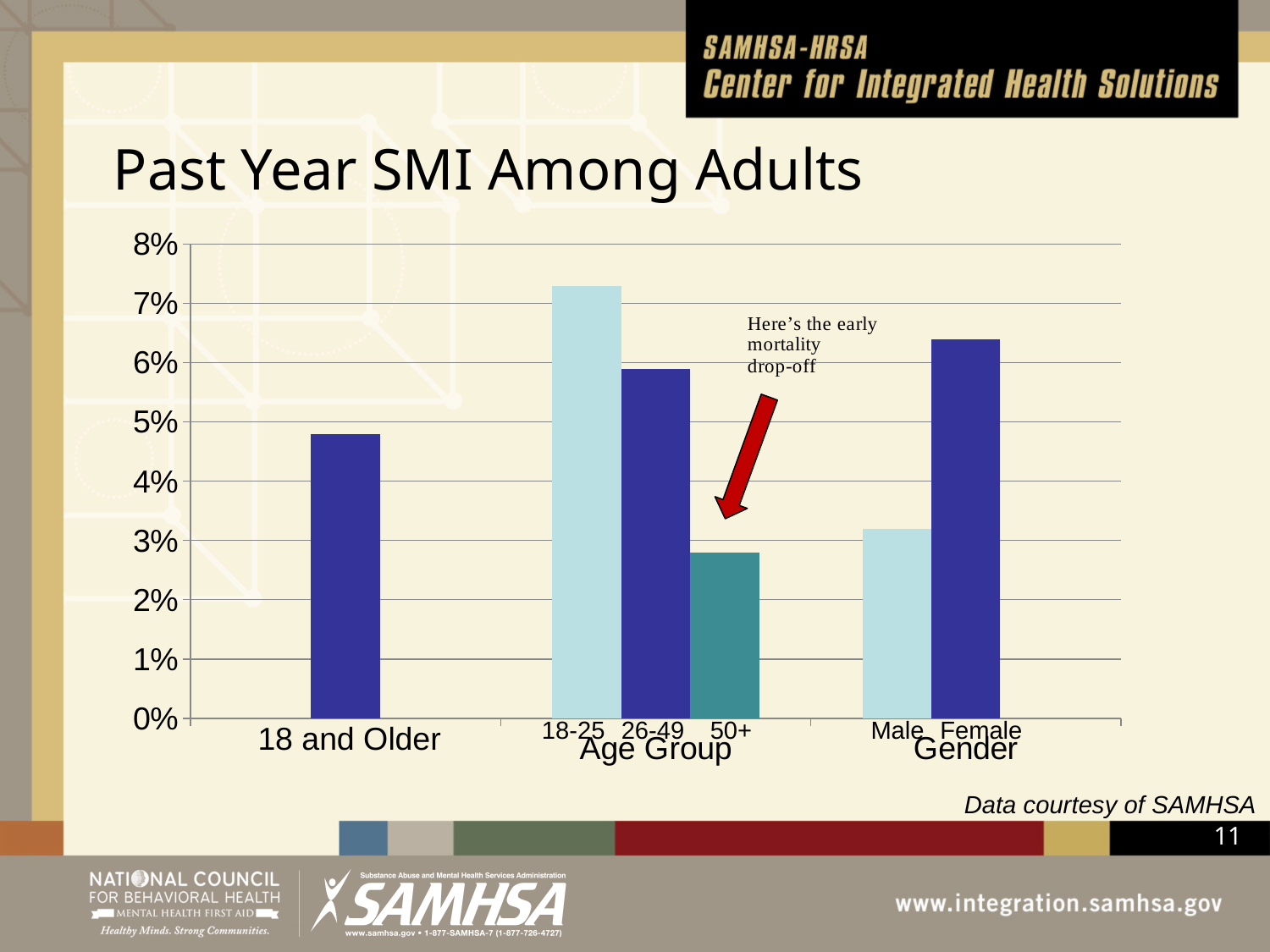
Which is larger, the value for 18-25 or the value for 26-49? 18-25 What kind of chart is shown on the slide? bar chart Which is larger, the value for Male or the value for Female? Female Which category has the lowest value in the chart? 50+ Is the value for Female greater or less than 6%? greater Which category has the highest value in the chart? 18-25 What does the annotation next to the red arrow say? Here's the early mortality drop-off Is the value for 18-25 greater or less than 7%? greater Is the value for 18 and Older greater or less than 4%? greater How many bars are plotted in the chart? 6 What is the title of the chart? Past Year SMI Among Adults